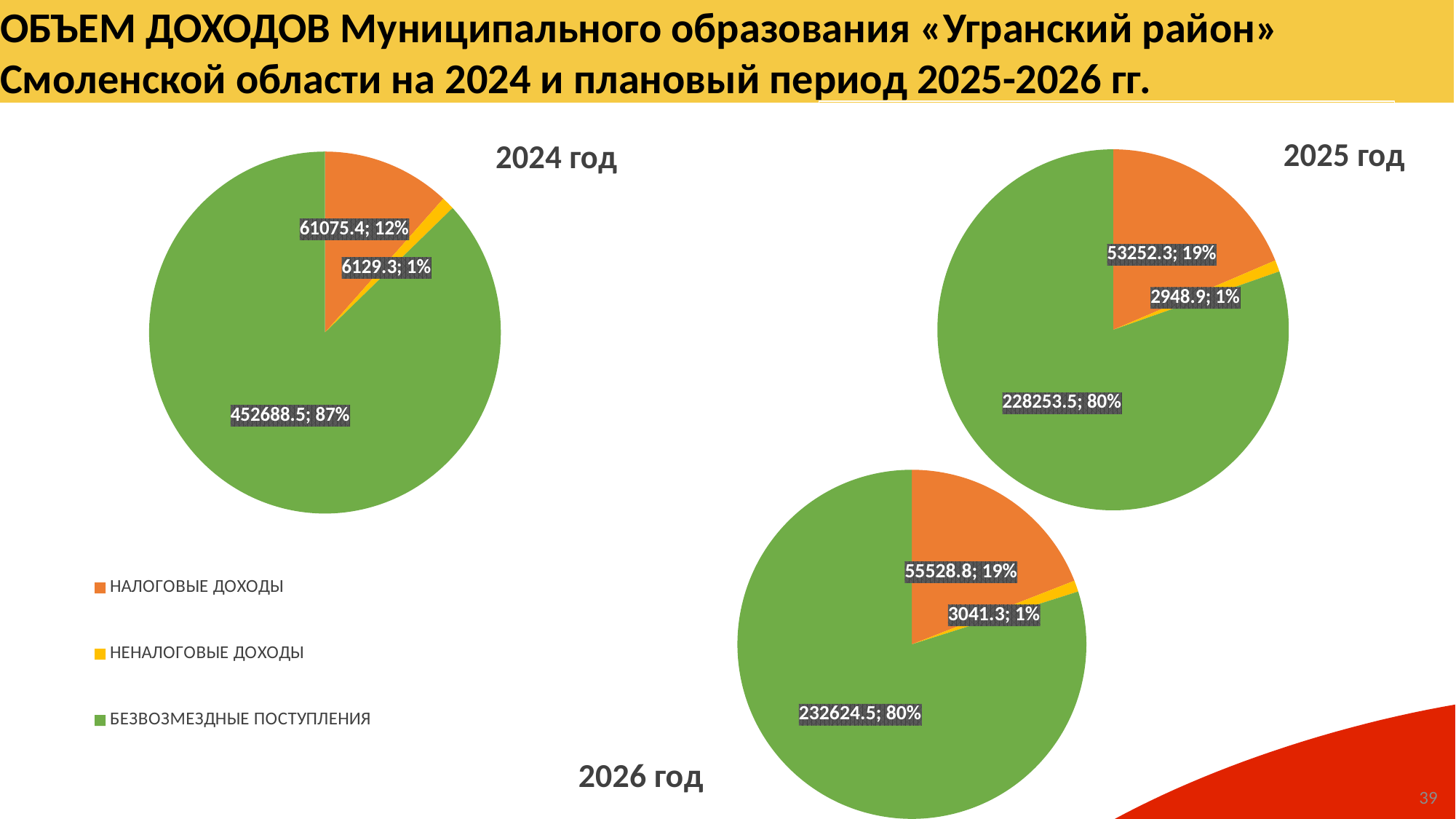
How many slices does the 2024 год pie chart have? 3 In the 2026 год pie chart, which category has the smallest slice? НЕНАЛОГОВЫЕ ДОХОДЫ What type of chart is used for 2025 год? Pie chart In the 2024 год pie chart, which category has the largest slice? БЕЗВОЗМЕЗДНЫЕ ПОСТУПЛЕНИЯ How many entries does the legend list? 3 In the 2025 год pie chart, what share does НАЛОГОВЫЕ ДОХОДЫ have? 19% In the 2025 год pie chart, what is the value for НЕНАЛОГОВЫЕ ДОХОДЫ? 2948.9 In the 2026 год pie chart, what is the value for БЕЗВОЗМЕЗДНЫЕ ПОСТУПЛЕНИЯ? 232624.5 In the 2025 год pie chart, which is larger: НАЛОГОВЫЕ ДОХОДЫ or НЕНАЛОГОВЫЕ ДОХОДЫ? НАЛОГОВЫЕ ДОХОДЫ In the 2024 год pie chart, what is the value for НАЛОГОВЫЕ ДОХОДЫ? 61075.4 In the 2024 год pie chart, what share does БЕЗВОЗМЕЗДНЫЕ ПОСТУПЛЕНИЯ have? 87% In the 2026 год pie chart, what is the difference between НАЛОГОВЫЕ ДОХОДЫ and НЕНАЛОГОВЫЕ ДОХОДЫ? 52487.5